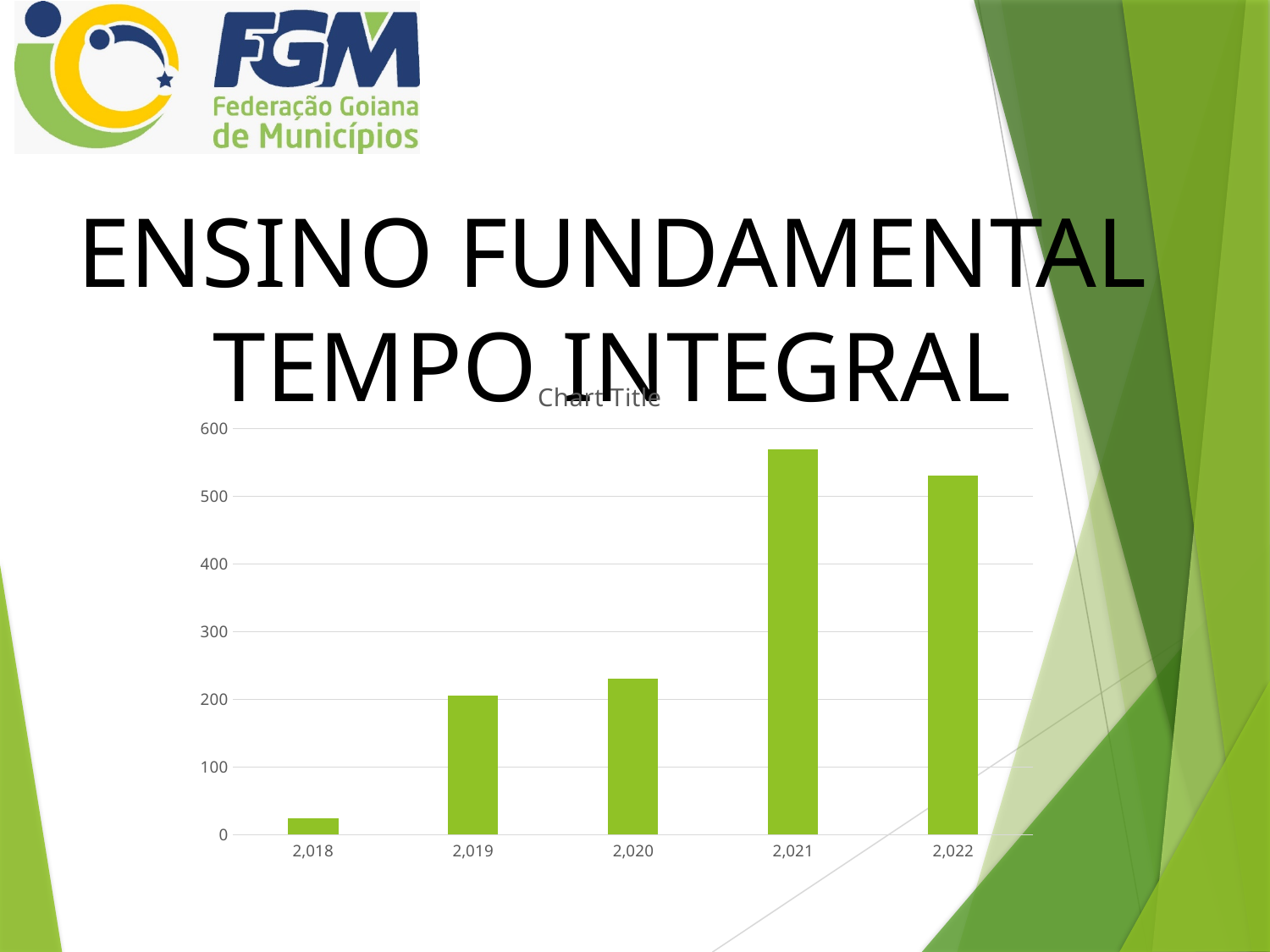
Which is larger, the value for 2,018 or the value for 2,019? 2,019 How many categories (years) are plotted on the x axis of the chart? 5 Which is larger, the value for 2,021 or the value for 2,022? 2,021 What kind of chart is shown on the slide? bar chart Is the value for 2,022 greater or less than 600? less Which year has the lowest bar in the chart? 2,018 Is the value for 2,020 greater or less than 200? greater Which year has the highest bar in the chart? 2,021 Is the value for 2,021 greater or less than 500? greater What is the title printed above the chart? Chart Title Do the values rise or fall from 2,018 to 2,021? rise